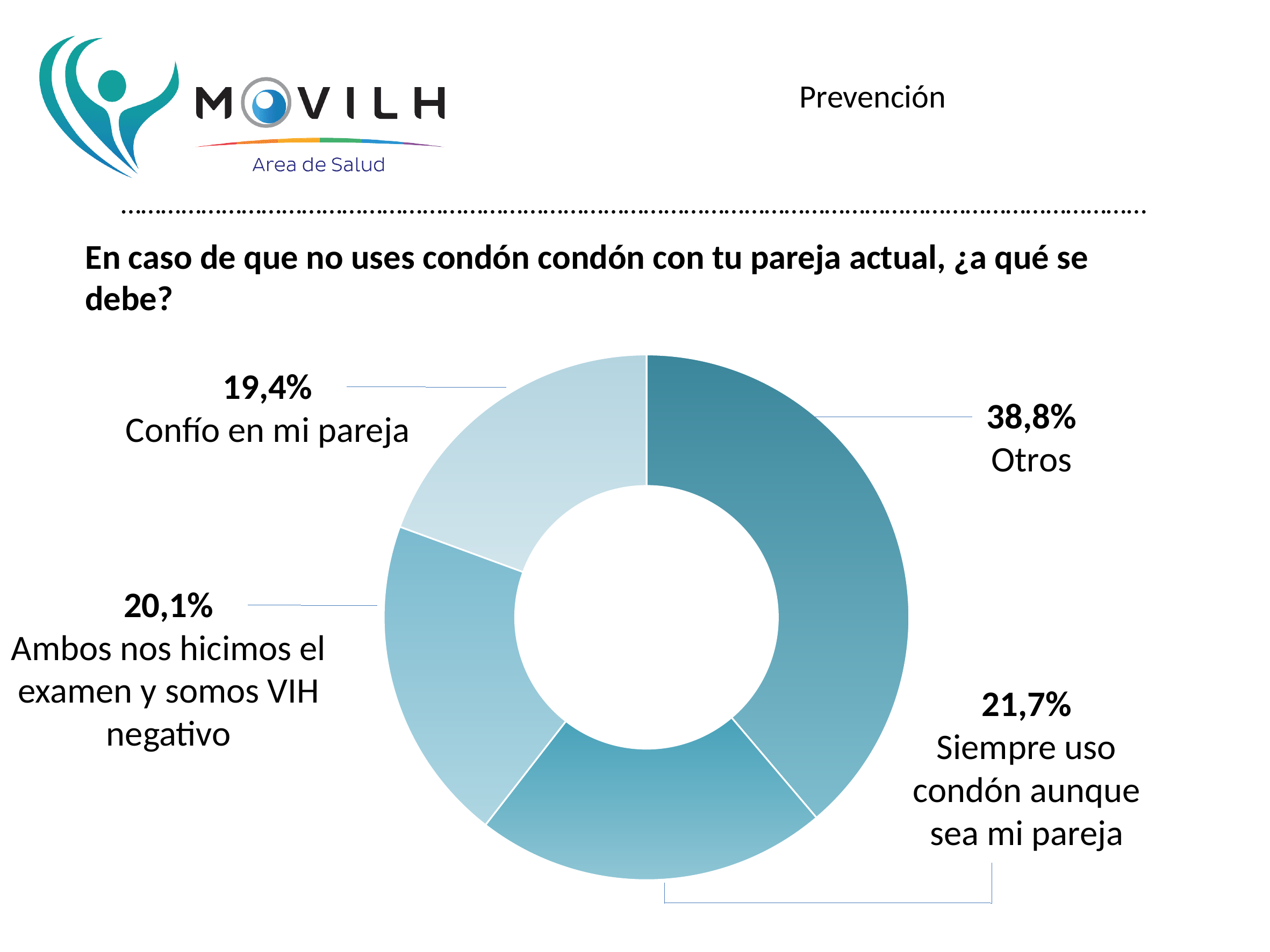
What percentage is shown for "Ambos nos hicimos el examen y somos VIH negativo"? 20,1% What question does the chart on the slide answer? En caso de que no uses condón condón con tu pareja actual, ¿a qué se debe? What kind of chart is shown on the slide? Donut (pie) chart Which category has the smallest share of the chart? Confío en mi pareja How many categories are shown in the chart? 4 What share is shown for "Confío en mi pareja"? 19,4% Which category has the largest share of the chart? Otros What percentage corresponds to "Siempre uso condón aunque sea mi pareja"? 21,7% Which is larger: the share for "Siempre uso condón aunque sea mi pareja" or the share for "Ambos nos hicimos el examen y somos VIH negativo"? Siempre uso condón aunque sea mi pareja What is the difference in percentage points between "Ambos nos hicimos el examen y somos VIH negativo" and "Confío en mi pareja"? 0,7 What is the difference in percentage points between "Otros" and "Siempre uso condón aunque sea mi pareja"? 17,1 What percentage of respondents answered "Otros"? 38,8%